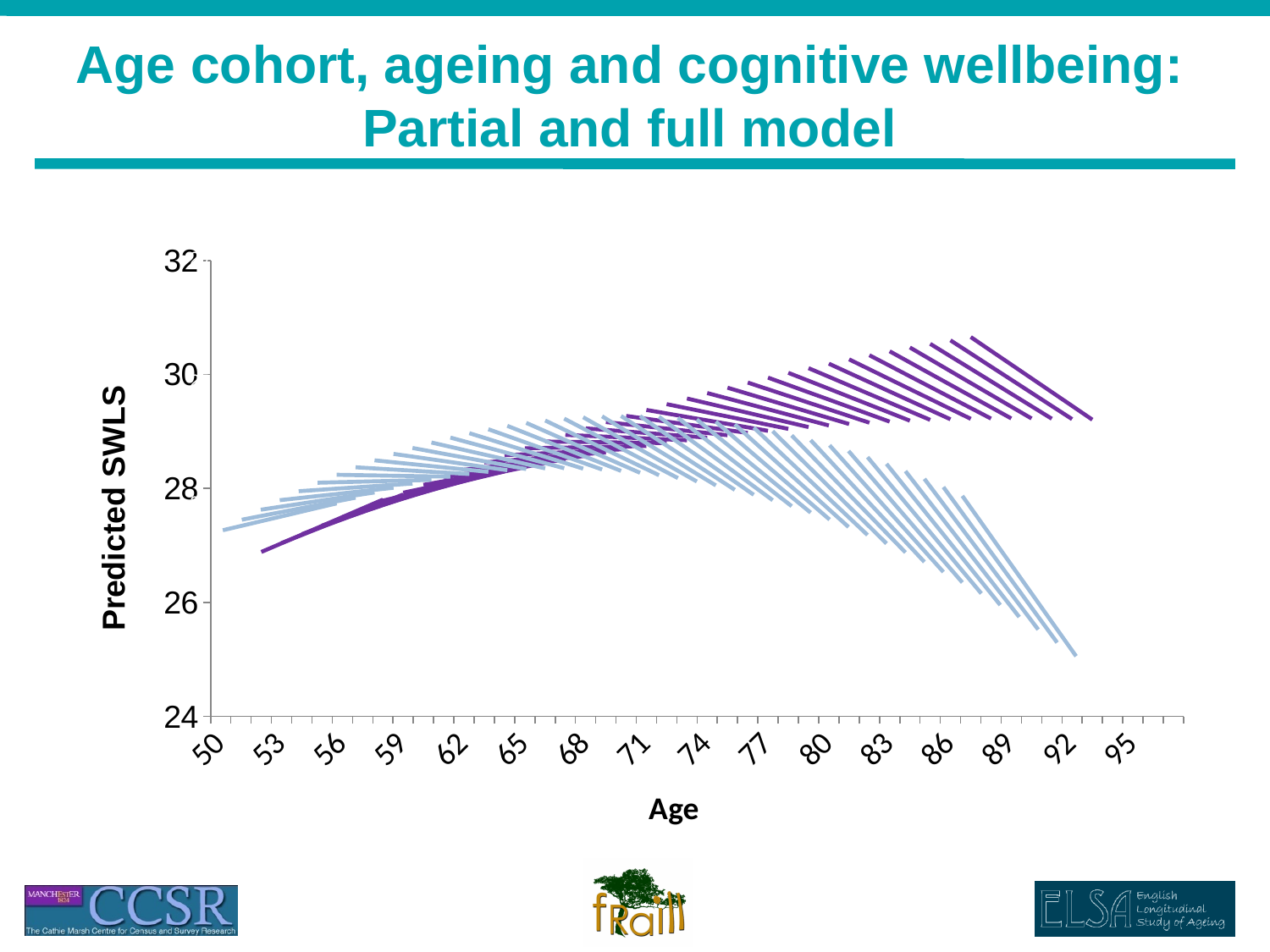
Is the value of the purple line at age 52 greater or less than 28? less At age 55, which set of lines has the higher Predicted SWLS, the purple or the light blue? light blue What kind of chart is shown on the slide? line chart Is the value of the light blue lines at age 92 greater or less than 26? less Is the highest value reached by the purple lines greater or less than 30? greater Do the purple lines generally rise or fall as age increases from 52 to 88? rise How many differently coloured sets of lines are plotted on the chart? 2 At age 92, which set of lines has the higher Predicted SWLS, the purple or the light blue? purple Do the light blue lines rise or fall as age increases from 75 to 92? fall What is the label of the vertical axis? Predicted SWLS What is the label of the horizontal axis? Age